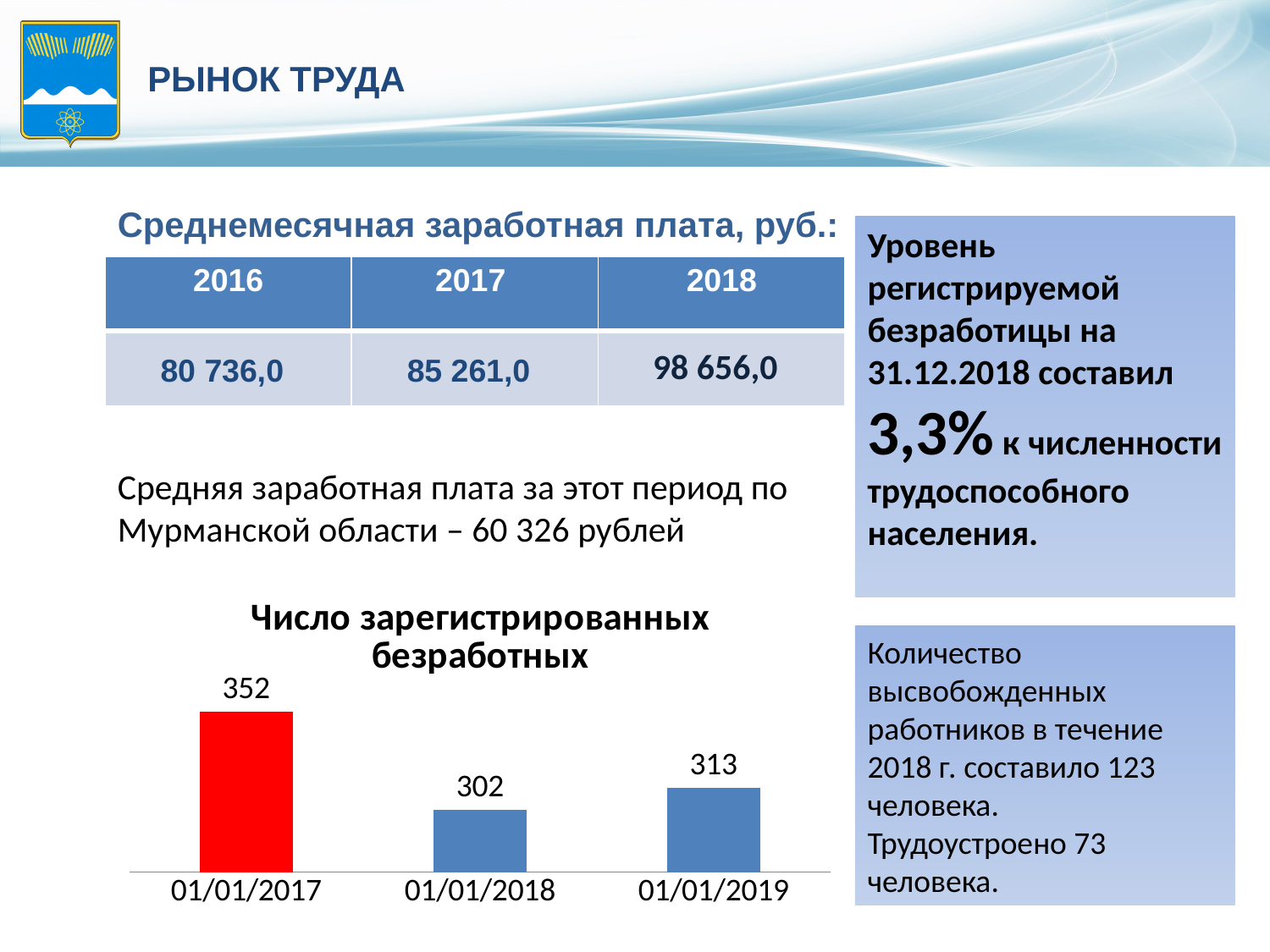
How many bars are shown in the chart? 3 What is the difference between the values for 01/01/2017 and 01/01/2018? 50 What is the value for 01/01/2018 in the chart? 302 What is the value for 01/01/2017 in the chart? 352 Which date has the highest value in the chart? 01/01/2017 Which is larger, the value for 01/01/2017 or the value for 01/01/2019? 01/01/2017 What type of chart is shown on the slide? bar chart Which bar in the chart is coloured red? 01/01/2017 What is the title of the chart on the slide? Число зарегистрированных безработных What is the difference between the values for 01/01/2019 and 01/01/2018? 11 What is the value for 01/01/2019 in the chart? 313 Which date has the lowest value in the chart? 01/01/2018